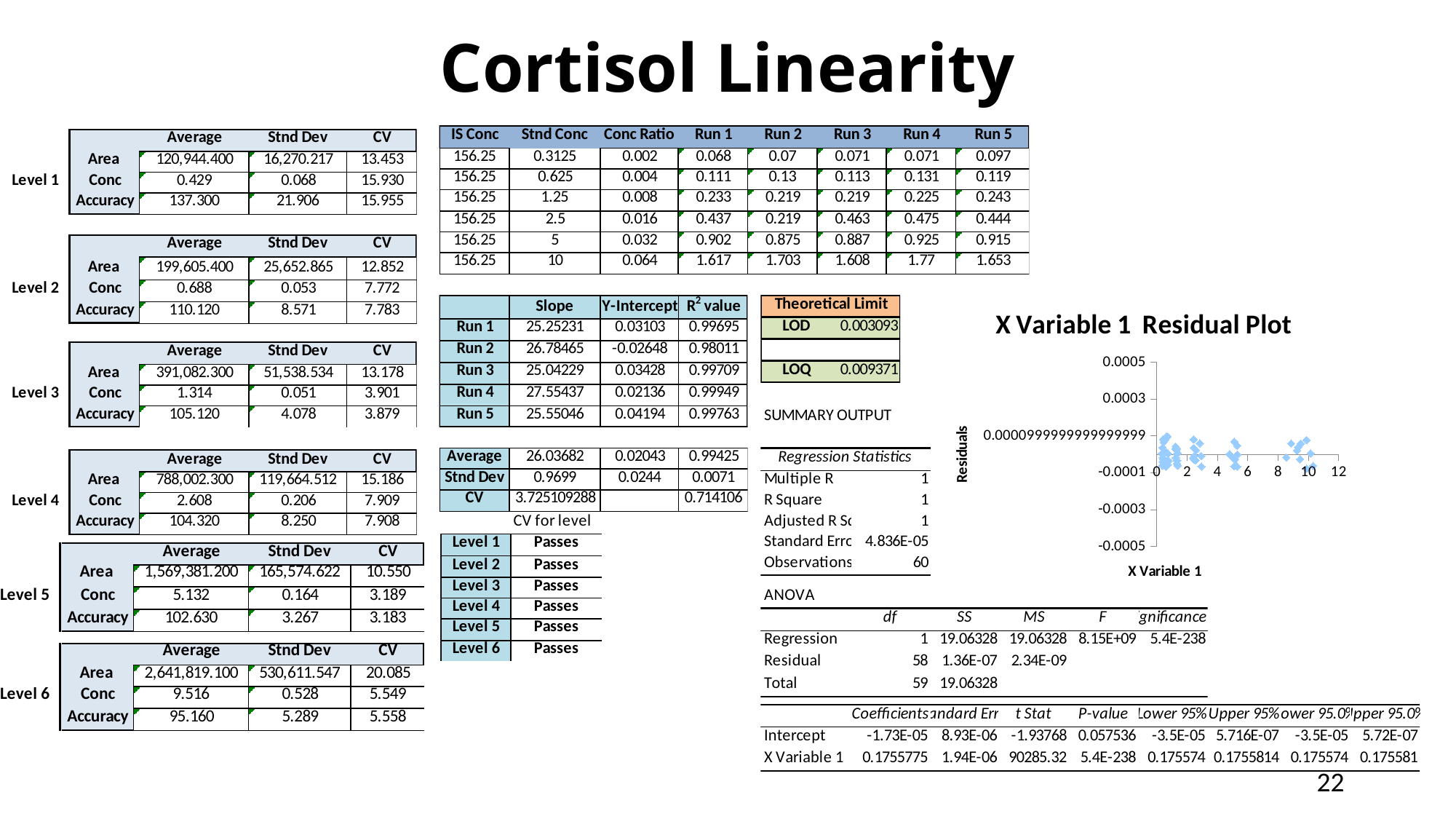
In the X Variable 1 Residual Plot, is the lowest residual value greater or less than -0.0003? greater What is the title of the chart on the right side of the slide? X Variable 1 Residual Plot In the X Variable 1 Residual Plot, is the highest residual value greater or less than 0.0003? less In the X Variable 1 Residual Plot, are the x values of the plotted points greater or less than 12? less What is the label of the vertical axis in the X Variable 1 Residual Plot? Residuals What kind of chart is the X Variable 1 Residual Plot? scatter plot